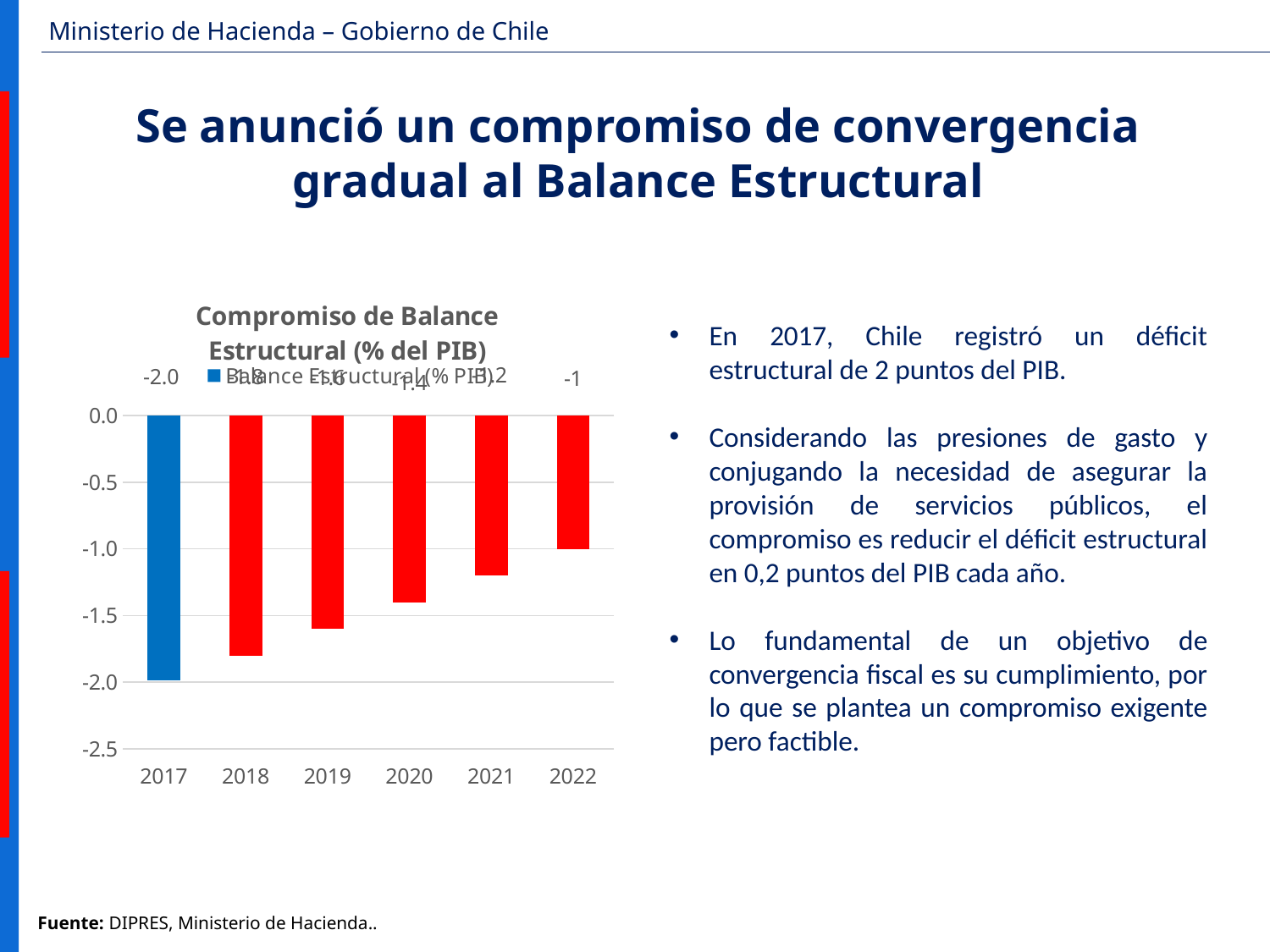
What is the value for 2022 in the Compromiso de Balance Estructural chart? -1 Which year has the highest (least negative) value in the chart? 2022 Is the value for 2018 greater or less than -1.5? less What is the difference between the values for 2017 and 2022? 1.0 Which is larger, the value for 2017 or the value for 2022? 2022 How many years are shown on the x axis of the chart? 6 What is the value for 2017 in the Compromiso de Balance Estructural chart? -2.0 Is the value for 2021 greater or less than -1.5? greater Do the values rise or fall from 2017 to 2022? Rise What kind of chart is shown on the slide? Bar chart Which year has the lowest (most negative) value in the chart? 2017